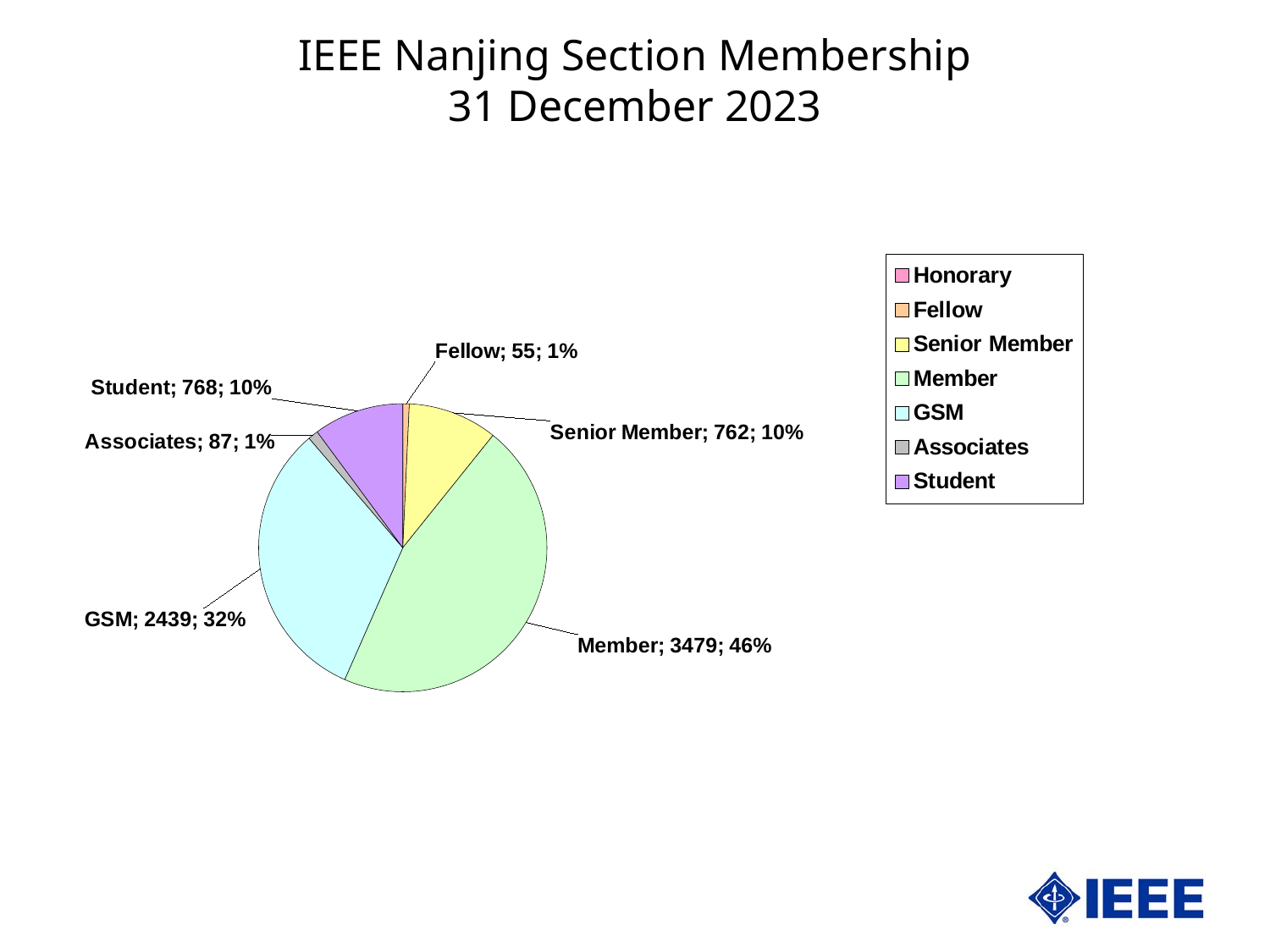
How many members are in the GSM category? 2439 What type of chart is shown on the slide? pie chart What is the difference between the Member count and the GSM count? 1040 Which is larger, the GSM count or the Student count? GSM How many Fellows are shown in the chart? 55 What share of the pie does the Member slice represent? 46% How many members are in the Member category? 3479 Which category has the largest slice of the pie? Member Of the labelled slices, which category has the smallest count? Fellow What percentage of the membership is Senior Member? 10% How many entries does the legend list? 7 How many Associates are shown in the chart? 87